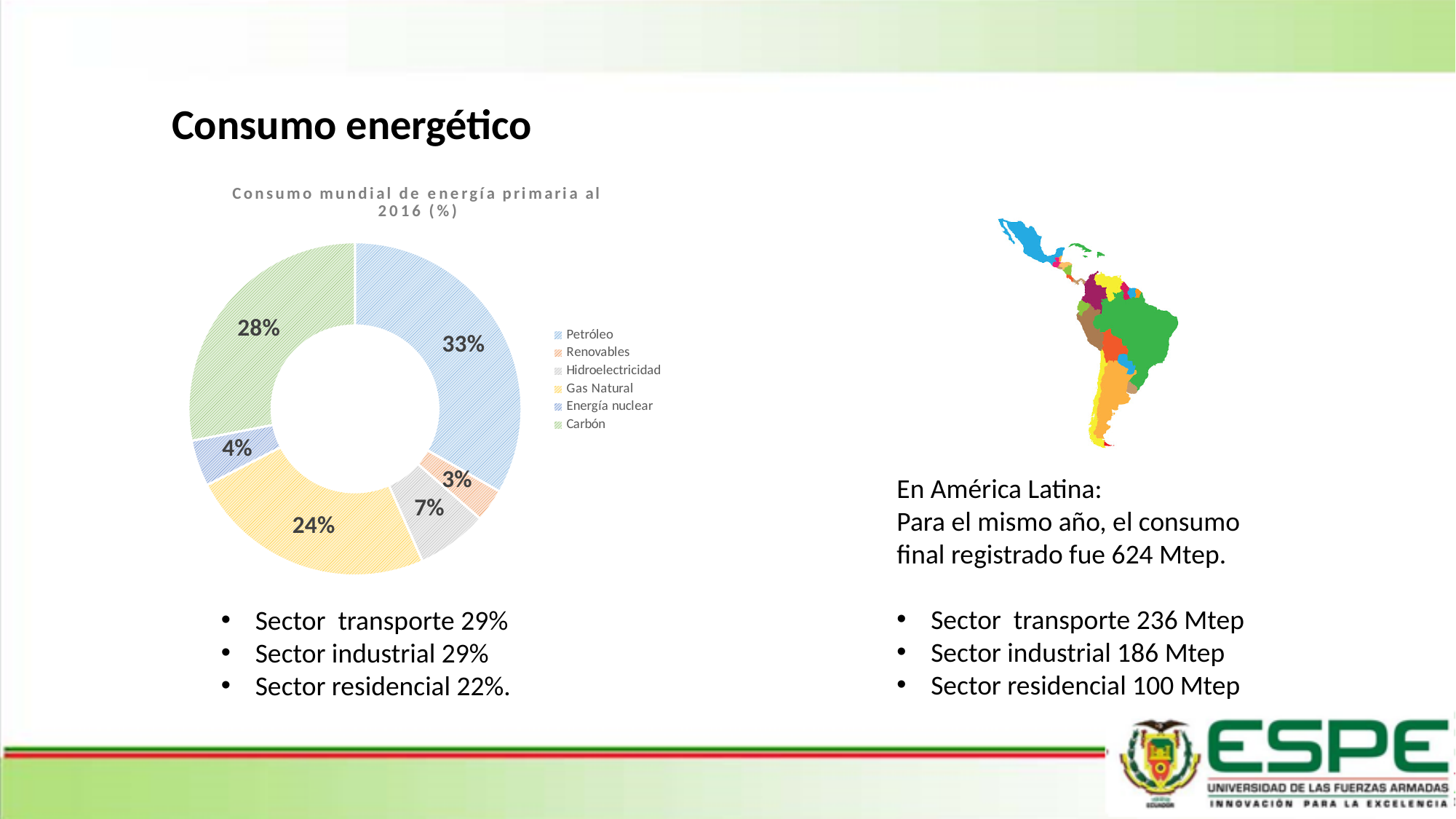
What type of chart is shown on the slide? Doughnut chart Which has a larger share, Gas Natural or Hidroelectricidad? Gas Natural What is the difference between the shares of Petróleo and Carbón? 5% What is the title of the chart? Consumo mundial de energía primaria al 2016 (%) What percentage of world primary energy consumption does Petróleo account for? 33% Which energy source has the largest share in the chart? Petróleo What is the value shown for Energía nuclear? 4% What is the value shown for Carbón? 28% What is the value shown for Gas Natural? 24% Which energy source has the smallest share in the chart? Renovables What is the value shown for Hidroelectricidad? 7% How many energy sources are listed in the chart legend? 6